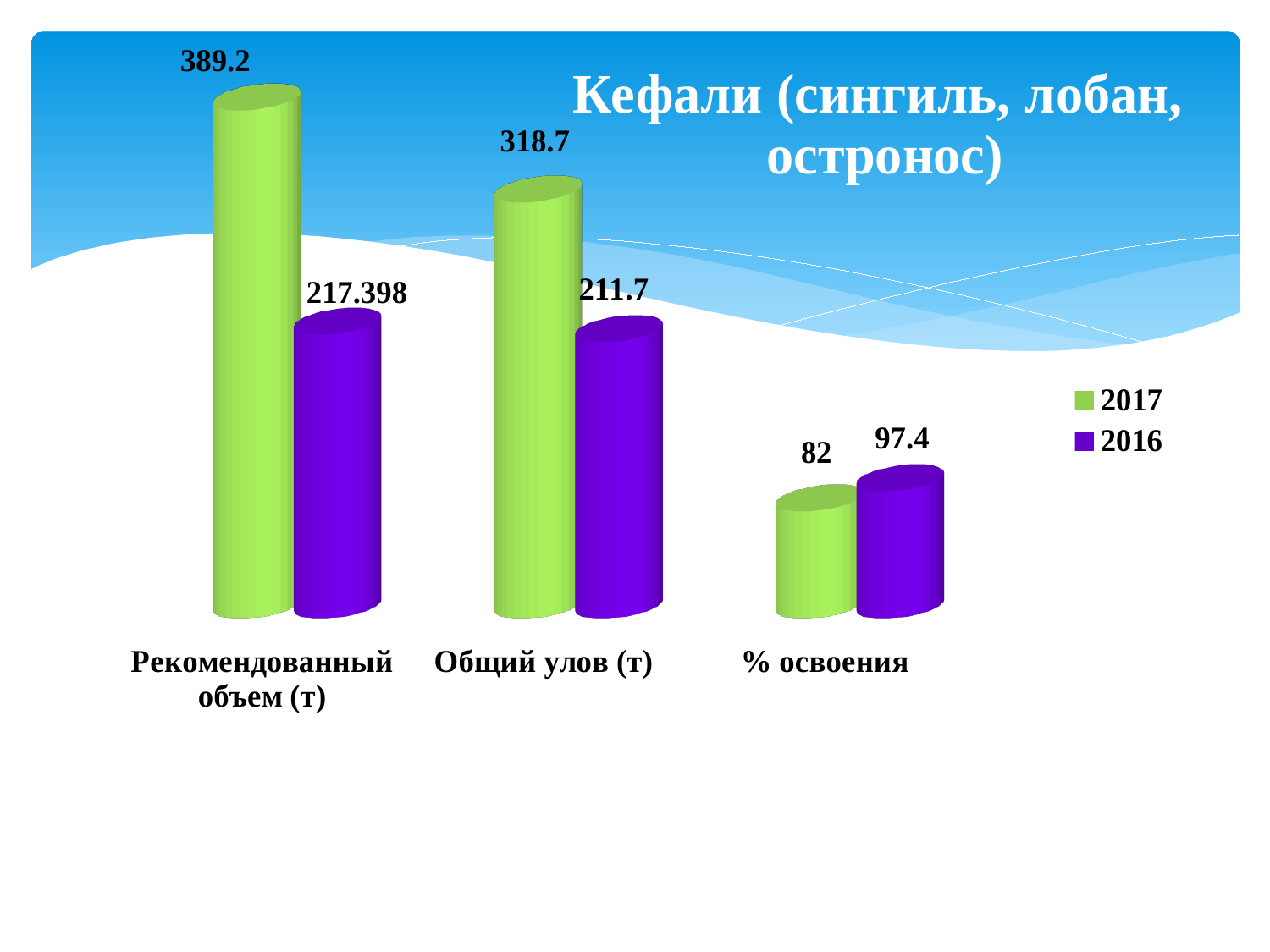
Which category has the lowest value for the 2016 series? % освоения What is the value for 2016 in the category "Рекомендованный объем (т)"? 217.398 What is the value for 2016 in the category "% освоения"? 97.4 What kind of chart is shown on the slide? Bar chart In the category "% освоения", which series has the larger value, 2017 or 2016? 2016 What is the value for 2017 in the category "Рекомендованный объем (т)"? 389.2 What is the title of the chart? Кефали (сингиль, лобан, остронос) Which category has the highest value for the 2017 series? Рекомендованный объем (т) What is the value for 2017 in the category "Общий улов (т)"? 318.7 How many categories are shown on the x axis of the chart? 3 How many series does the legend list? 2 What is the difference between the 2017 and 2016 values in the category "Общий улов (т)"? 107